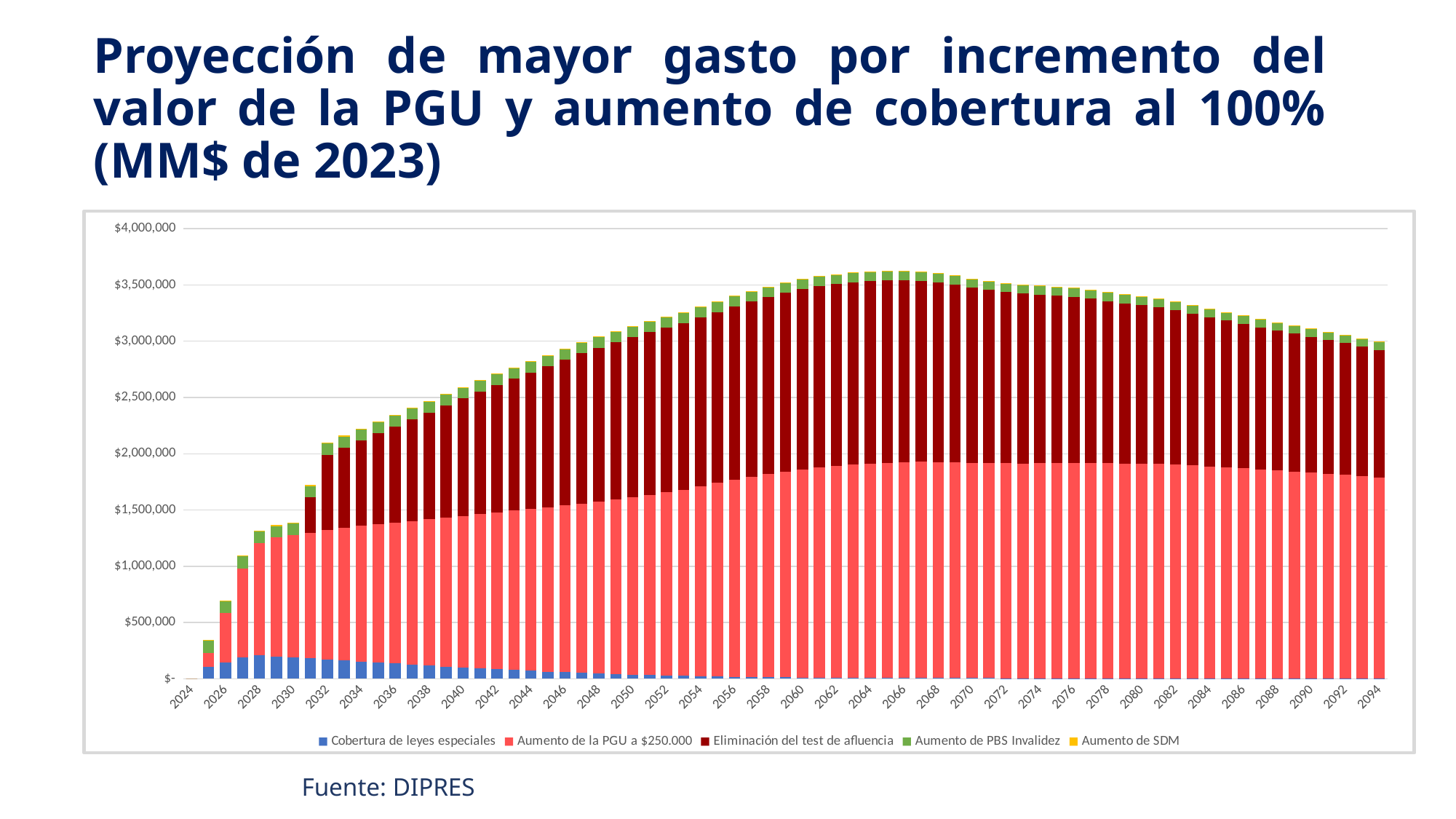
How many series does the legend list? 5 Which year has a larger total bar, 2030 or 2060? 2060 Do the total bars rise or fall from 2070 to 2094? fall Which year has the lowest total bar? 2024 Is the total bar for 2066 greater or less than $3,500,000? greater Is the total bar for 2032 greater or less than $2,000,000? greater Which series is shown in dark red in the legend? Eliminación del test de afluencia Is the total bar for 2026 greater or less than $500,000? greater What kind of chart is shown on the slide? Stacked bar chart Do the total bars rise or fall from 2024 to 2064? rise Which series is shown in yellow in the legend? Aumento de SDM